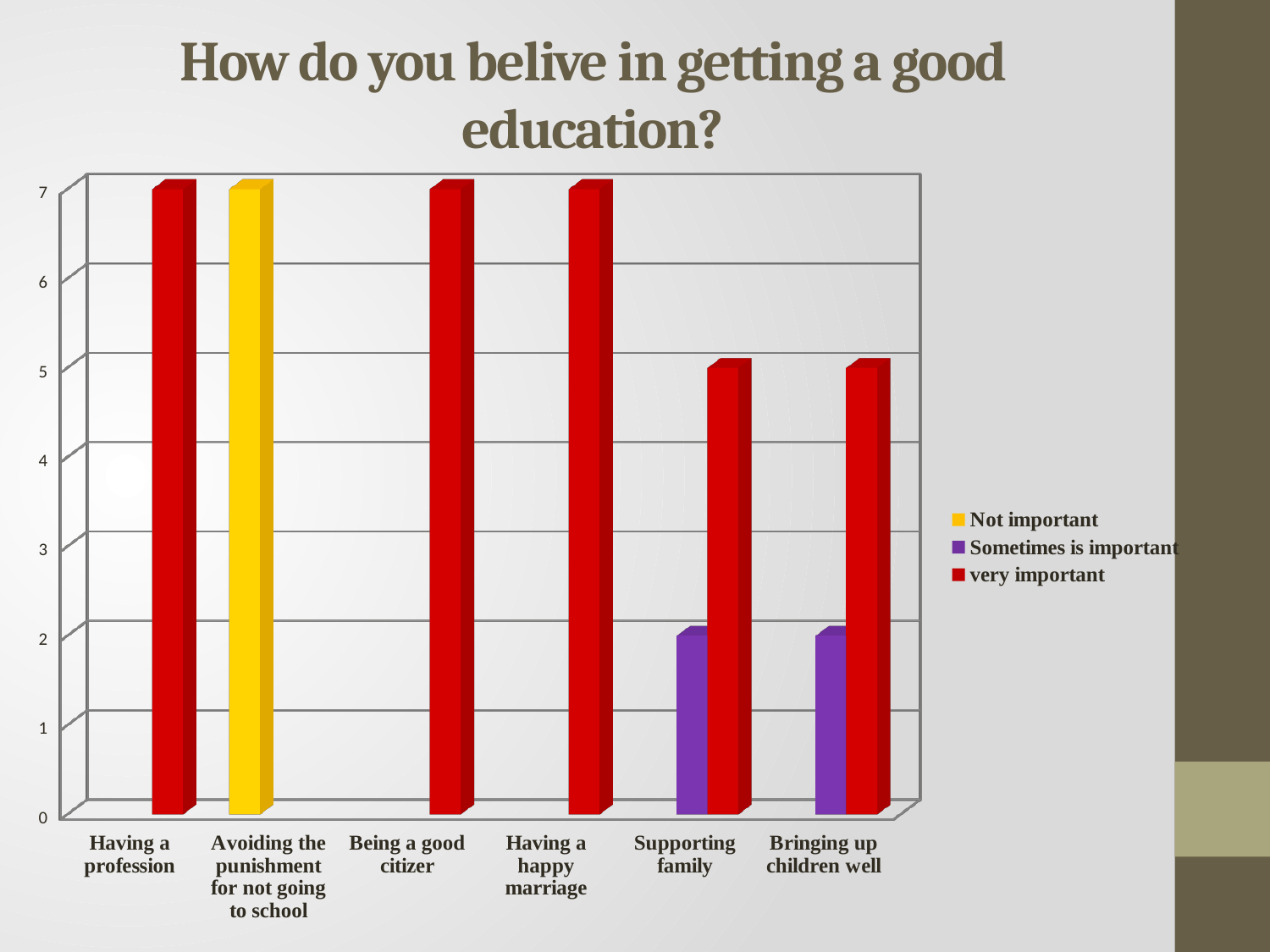
What is the difference between the 'very important' value for 'Being a good citizer' and the 'very important' value for 'Bringing up children well'? 2 What is the value of the 'Sometimes is important' bar for 'Bringing up children well'? 2 What colour represents the 'Sometimes is important' series in the legend? purple Is the 'very important' value for 'Having a happy marriage' greater or less than 6? greater Which category is the only one with a 'Not important' bar? Avoiding the punishment for not going to school What is the value of the 'Not important' bar for 'Avoiding the punishment for not going to school'? 7 Which is larger for 'Supporting family': the 'very important' bar or the 'Sometimes is important' bar? very important What is the value of the 'very important' bar for 'Having a profession'? 7 What kind of chart is shown on the slide? bar chart What is the value of the 'very important' bar for 'Supporting family'? 5 How many categories are shown on the x axis of the chart? 6 How many series does the legend list? 3